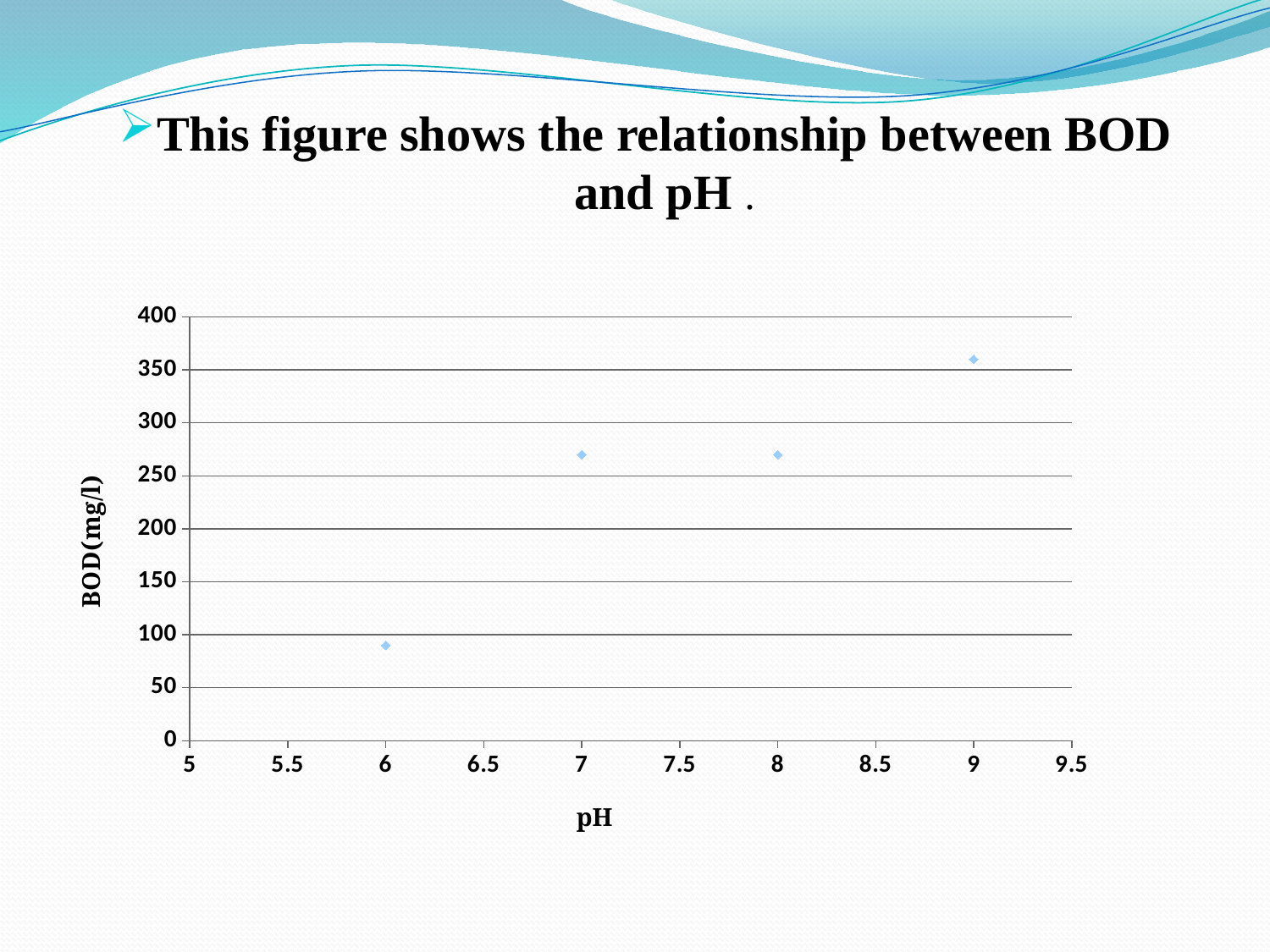
Which has a higher BOD value, pH 9 or pH 6? pH 9 At which pH value is the BOD lowest? 6 Is the BOD value at pH 9 greater or less than 350? greater What is the label on the vertical axis of the chart? BOD(mg/l) Is the BOD value at pH 8 greater or less than 300? less At which pH value is the BOD highest? 9 Which has a higher BOD value, pH 7 or pH 6? pH 7 Is the BOD value at pH 6 greater or less than 100? less What kind of chart is shown on the slide? scatter chart Does BOD generally rise or fall as pH increases along the x axis? rise How many data points are plotted on the chart? 4